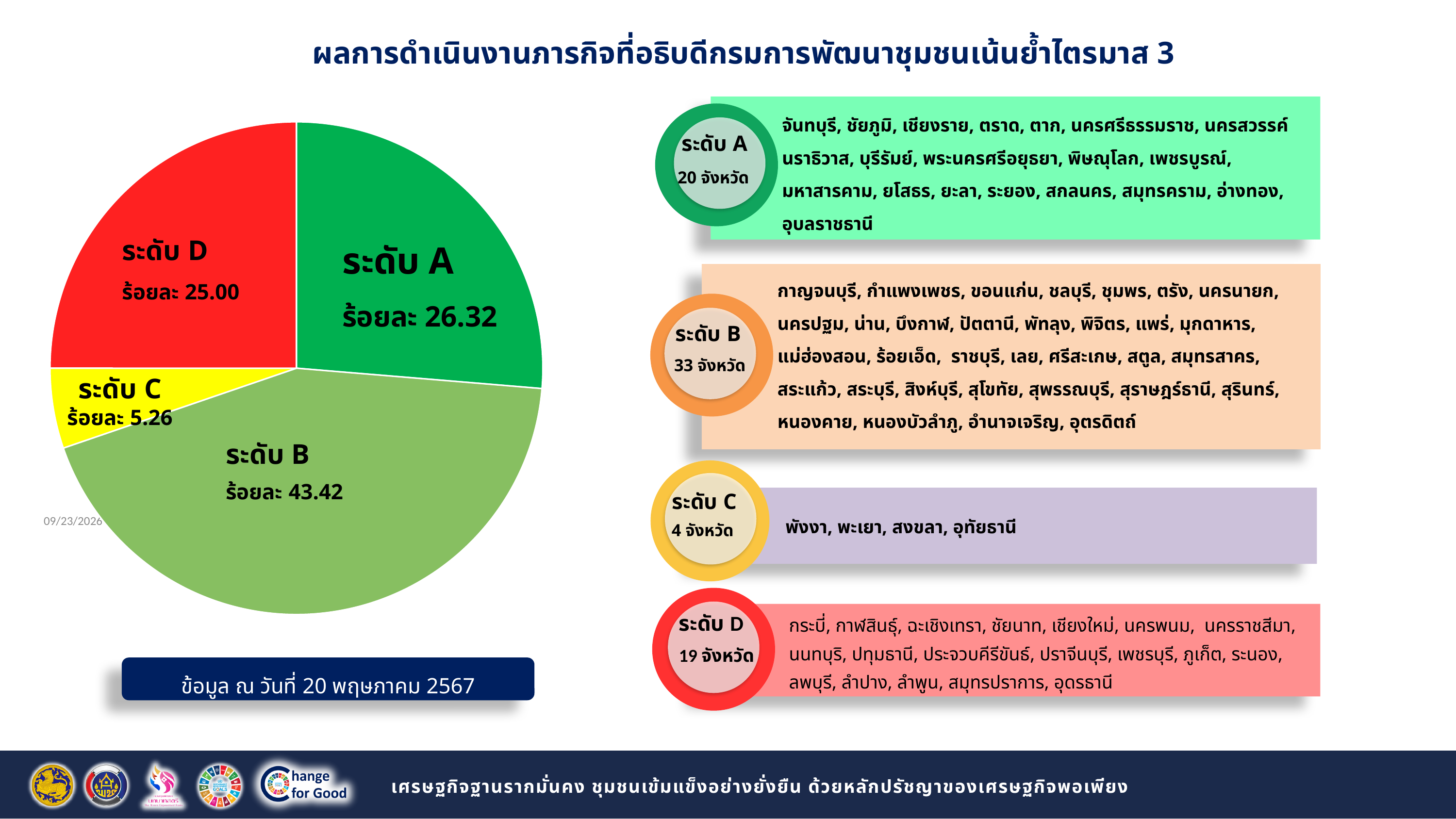
What is the value shown for ระดับ A in the pie chart? ร้อยละ 26.32 What is the value shown for ระดับ D in the pie chart? ร้อยละ 25.00 What is the difference between the values for ระดับ D and ระดับ C in the pie chart? 19.74 What colour is the ระดับ C slice in the pie chart? yellow What is the difference between the values for ระดับ B and ระดับ A in the pie chart? 17.10 Which is larger in the pie chart, the value for ระดับ A or the value for ระดับ D? ระดับ A What kind of chart is shown on the left of the slide? pie chart Which slice of the pie chart has the smallest share? ระดับ C What is the value shown for ระดับ C in the pie chart? ร้อยละ 5.26 What is the value shown for ระดับ B in the pie chart? ร้อยละ 43.42 Which slice of the pie chart has the largest share? ระดับ B How many slices does the pie chart have? 4